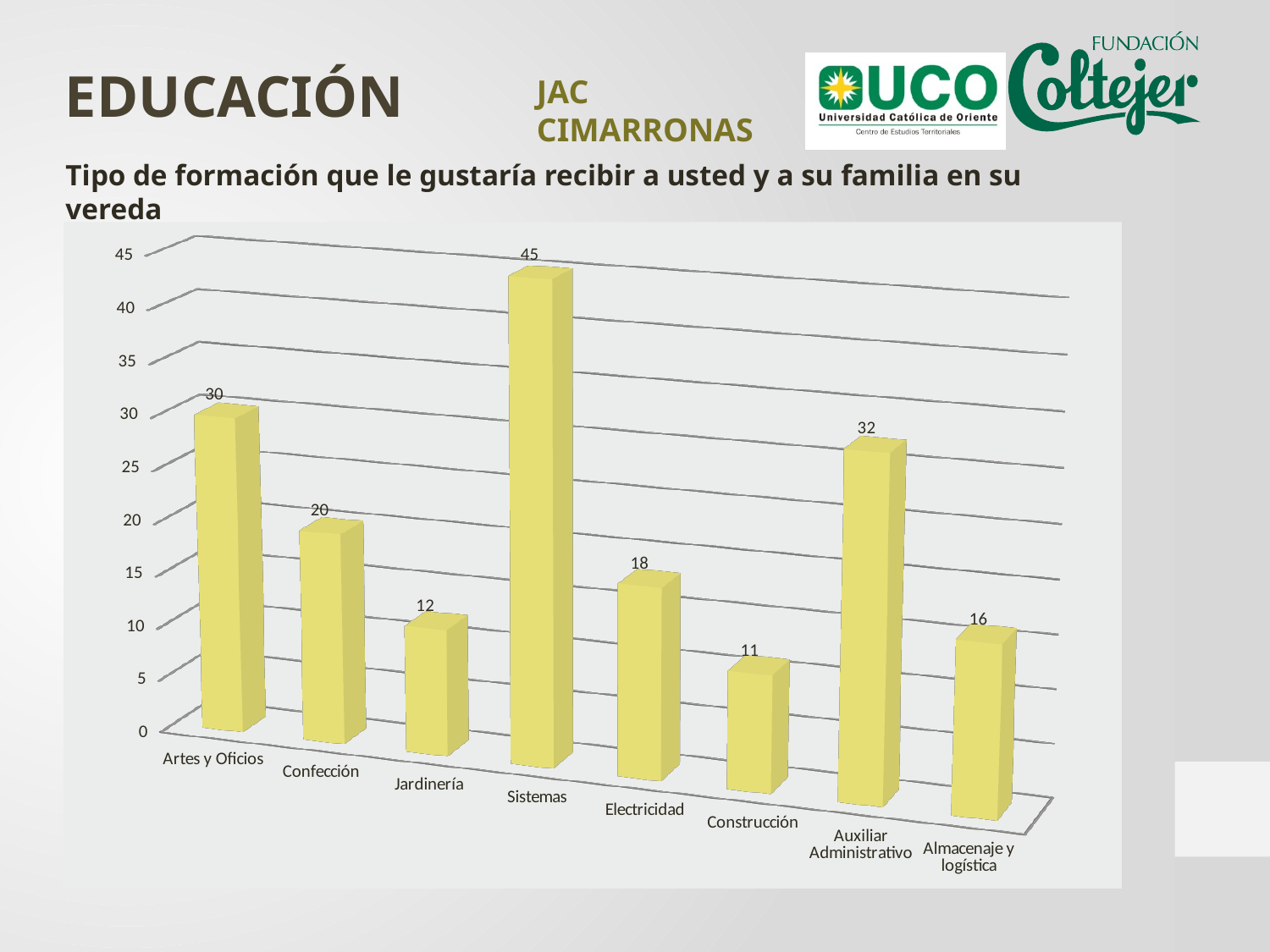
How many categories are shown on the x axis? 8 Which is larger, the value for Electricidad or the value for Almacenaje y logística? Electricidad What is the value for Sistemas? 45 What kind of chart is shown on the slide? Bar chart What is the difference between the values for Artes y Oficios and Confección? 10 Which category has the lowest value? Construcción What is the value for Construcción? 11 What is the difference between the values for Sistemas and Auxiliar Administrativo? 13 What is the value for Jardinería? 12 Which category has the highest value? Sistemas What is the value for Auxiliar Administrativo? 32 What is the title of the chart on the slide? Tipo de formación que le gustaría recibir a usted y a su familia en su vereda